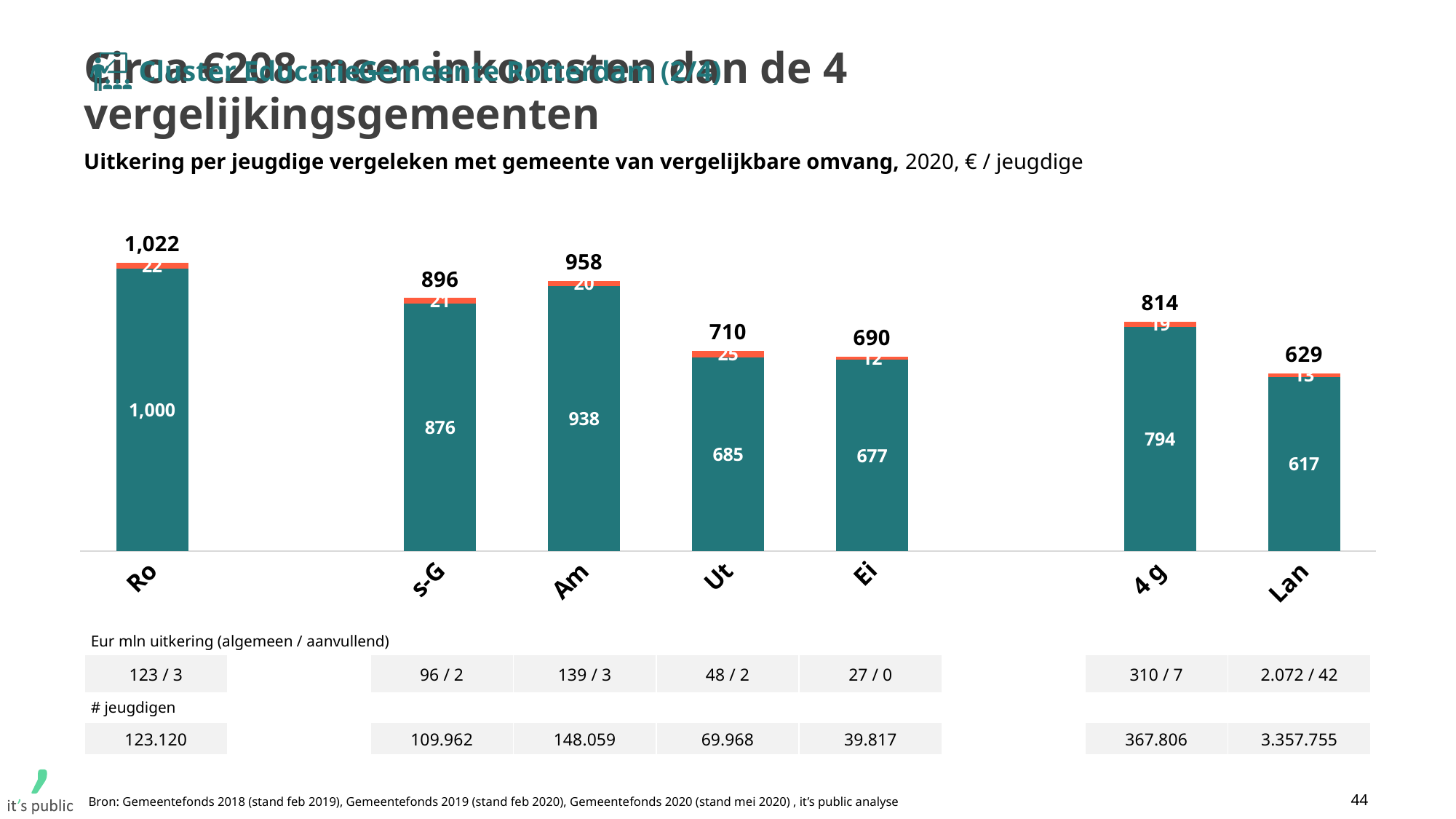
What kind of chart is shown on the slide? Stacked bar chart How many categories (bars) are shown on the x axis? 7 What is the total value shown above the bar for Ro? 1,022 Which has a larger total, Am or s-G? Am What is the difference between the teal segment of Am and the teal segment of Ut? 253 Which category has the lowest total value? Lan What is the total value shown above the bar for Ei? 690 Which category has the highest total value? Ro What is the value of the large teal segment of the Am bar? 938 What is the total value shown above the bar for Ut? 710 What is the difference between the total for Ro and the total for s-G? 126 What is the value of the small orange segment on top of the Ut bar? 25